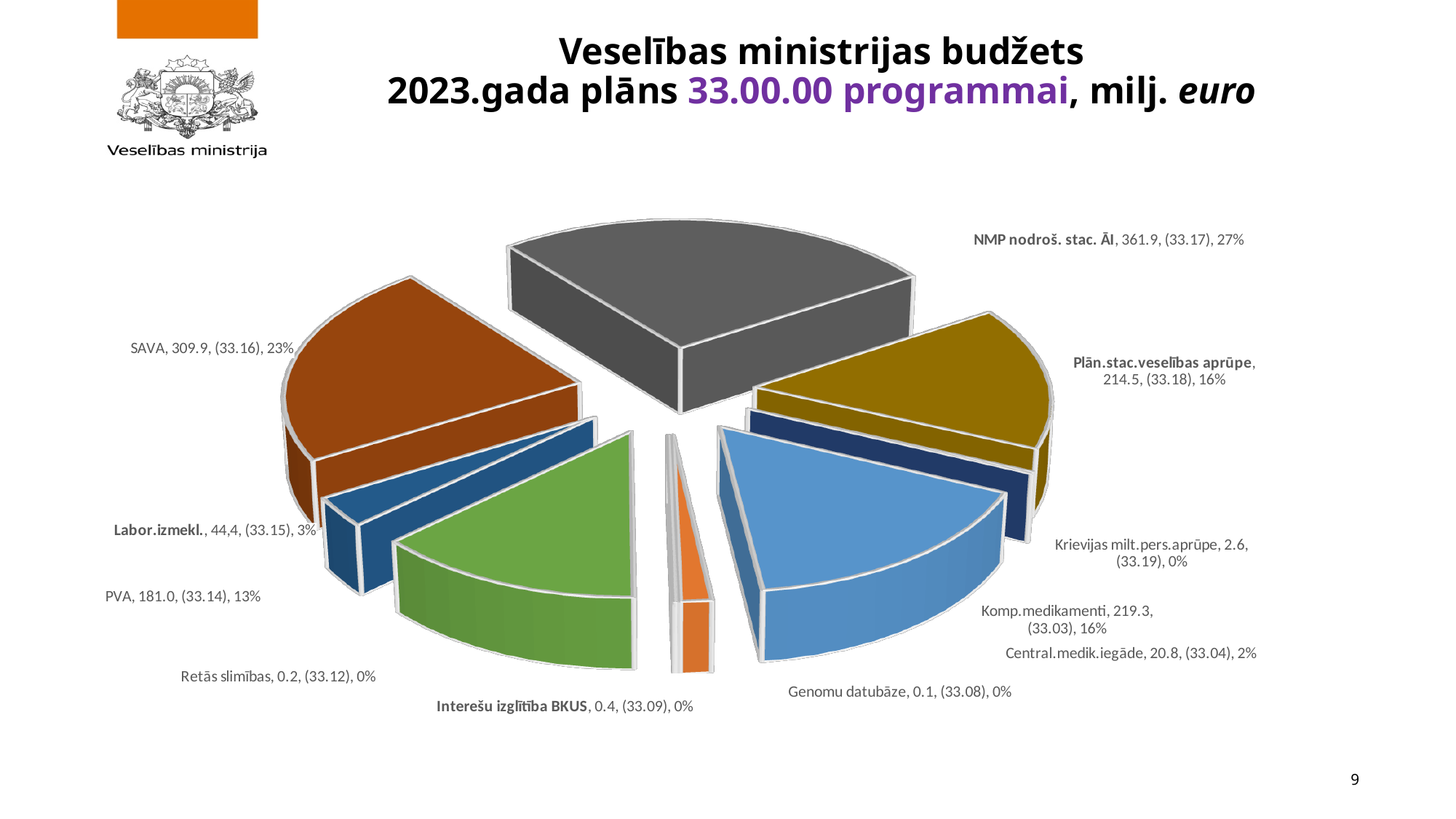
Which category has the smallest value? Genomu datubāze What is the value for NMP nodroš. stac. ĀI? 361.9 What is the difference between the values for NMP nodroš. stac. ĀI and SAVA? 52.0 What share of the pie does Central.medik.iegāde represent? 2% What share of the pie does SAVA represent? 23% Which category has the largest slice of the pie? NMP nodroš. stac. ĀI How many categories are shown in the pie chart? 11 What is the value for PVA? 181.0 What kind of chart is shown on the slide? Pie chart What is the value for SAVA? 309.9 Which is larger, the value for Komp.medikamenti or the value for Plān.stac.veselības aprūpe? Komp.medikamenti What is the value for Komp.medikamenti? 219.3